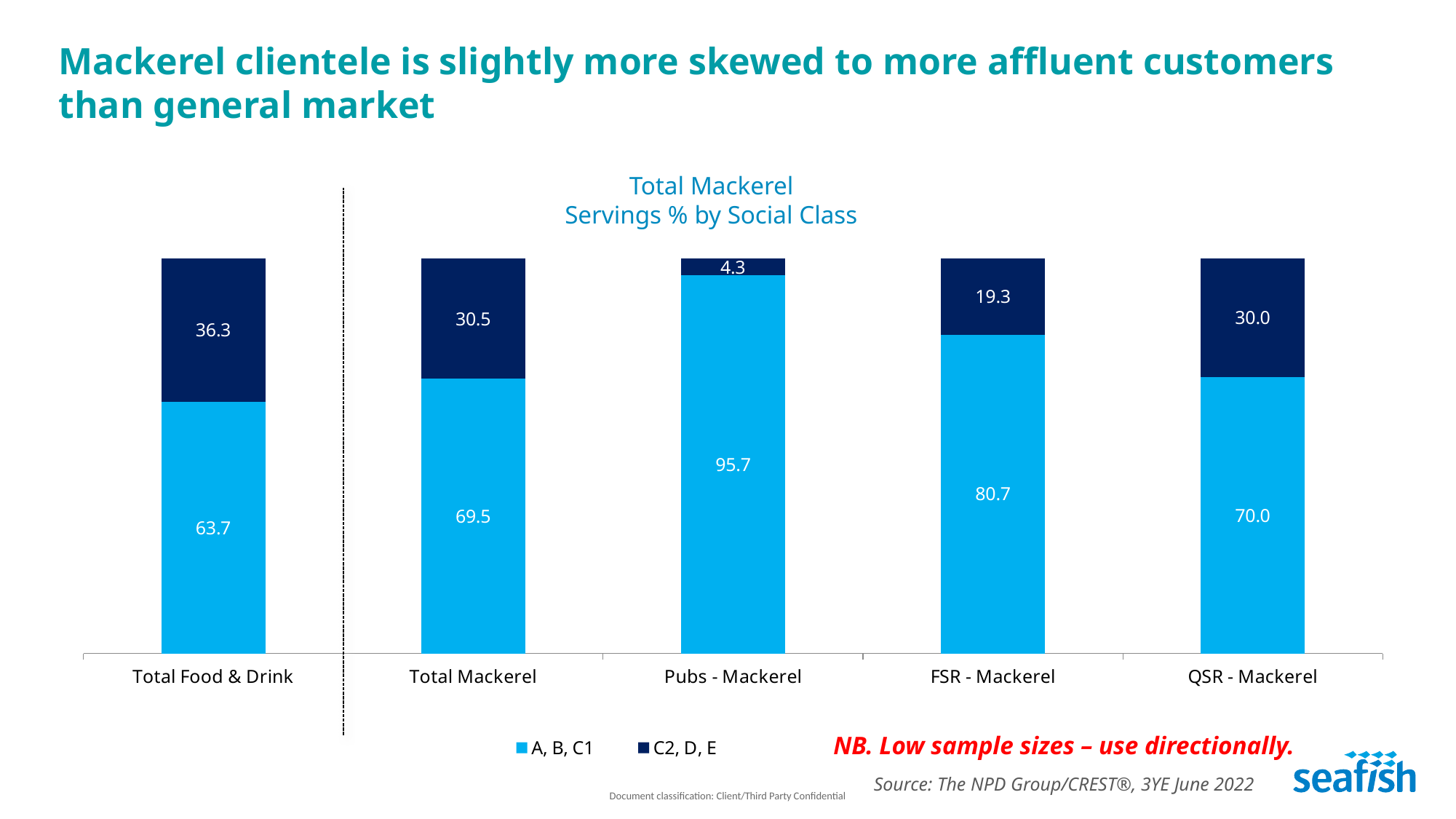
What is the C2, D, E value for QSR - Mackerel? 30.0 What is the C2, D, E value for Pubs - Mackerel? 4.3 Which is larger, the C2, D, E value for Total Food & Drink or for Total Mackerel? Total Food & Drink Which category has the lowest C2, D, E value? Pubs - Mackerel What is the total of the stacked bar for FSR - Mackerel? 100.0 What is the A, B, C1 value for Total Food & Drink? 63.7 How many series does the legend list? 2 What kind of chart is shown on the slide? Stacked bar chart Which category has the highest A, B, C1 value? Pubs - Mackerel What is the difference between the A, B, C1 values for Total Mackerel and Total Food & Drink? 5.8 How many categories are shown on the x axis? 5 What is the A, B, C1 value for FSR - Mackerel? 80.7